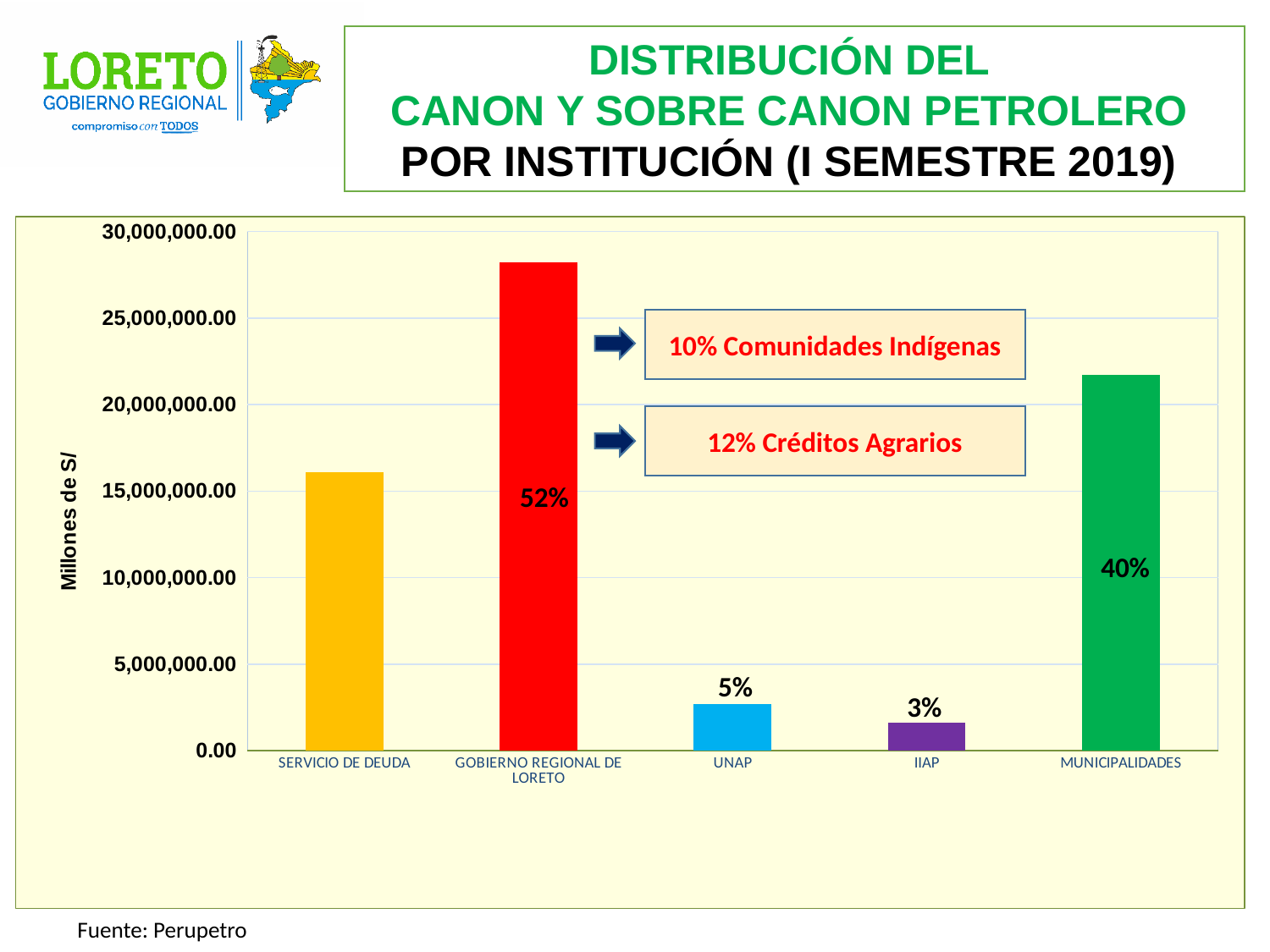
What percentage label is shown on the bar for MUNICIPALIDADES? 40% How many institutions are shown on the x axis of the chart? 5 Is the value for MUNICIPALIDADES greater or less than 25,000,000.00? less Is the value for SERVICIO DE DEUDA greater or less than 15,000,000.00? greater What type of chart is shown on the slide? Bar chart Which institution has the highest bar in the chart? GOBIERNO REGIONAL DE LORETO Which institution has the lowest bar in the chart? IIAP What percentage label is shown on the bar for GOBIERNO REGIONAL DE LORETO? 52% What percentage label is shown on the bar for IIAP? 3% Which bar is taller, SERVICIO DE DEUDA or MUNICIPALIDADES? MUNICIPALIDADES What percentage label is shown on the bar for UNAP? 5% What is the label of the vertical axis of the chart? Millones de S/